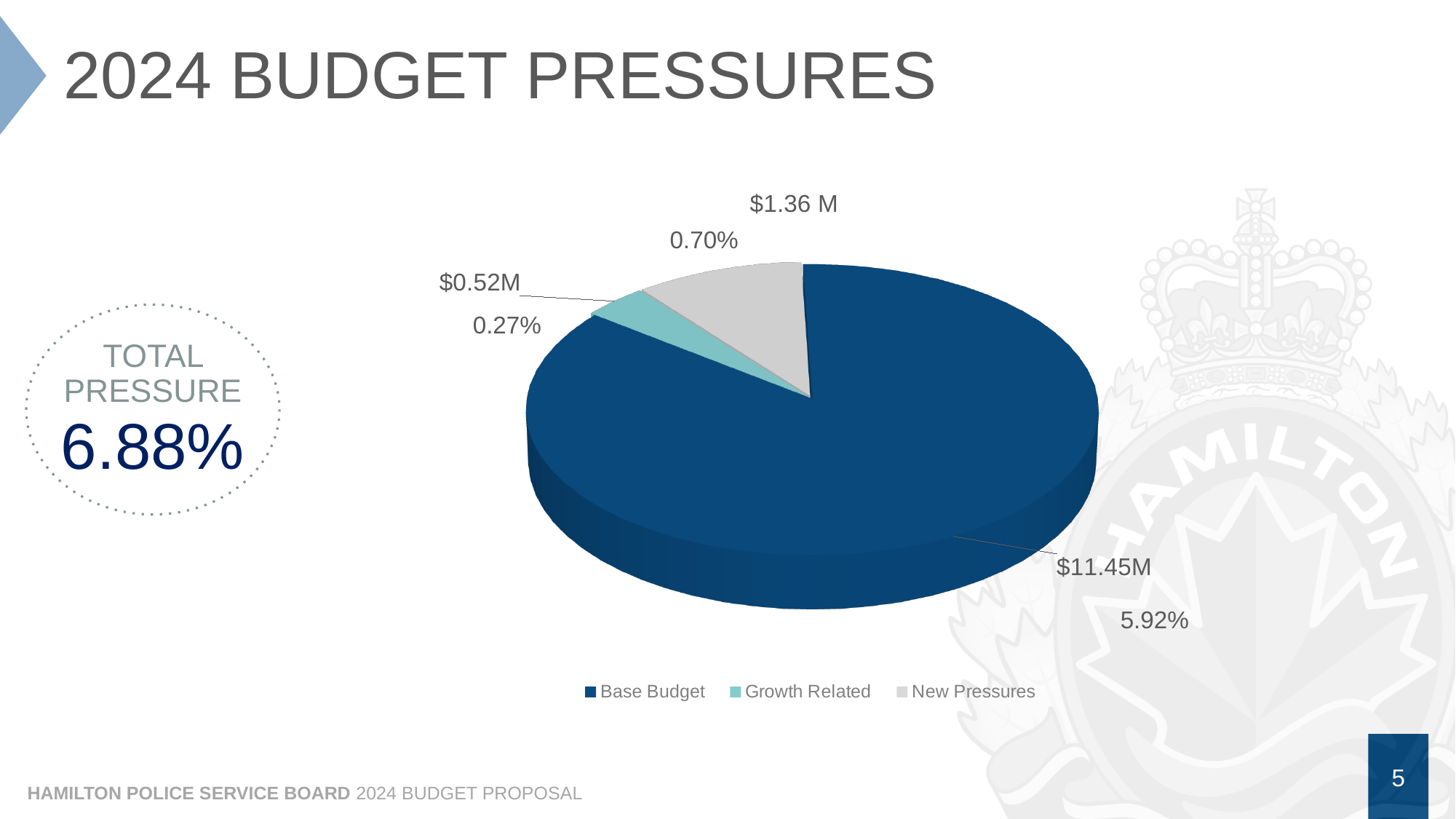
What is the difference in dollar value between the Base Budget slice and the New Pressures slice? $10.09M What dollar value is labelled for the Growth Related slice? $0.52M Which is larger, the New Pressures slice or the Growth Related slice? New Pressures What percentage is labelled for the Base Budget slice? 5.92% How many slices does the pie chart have? 3 What percentage is labelled for the Growth Related slice? 0.27% What type of chart is shown on the slide? pie chart How many entries does the legend of the pie chart list? 3 Which slice of the pie chart is the smallest? Growth Related What dollar value is labelled for the Base Budget slice? $11.45M What dollar value is labelled for the New Pressures slice? $1.36 M Which slice of the pie chart is the largest? Base Budget